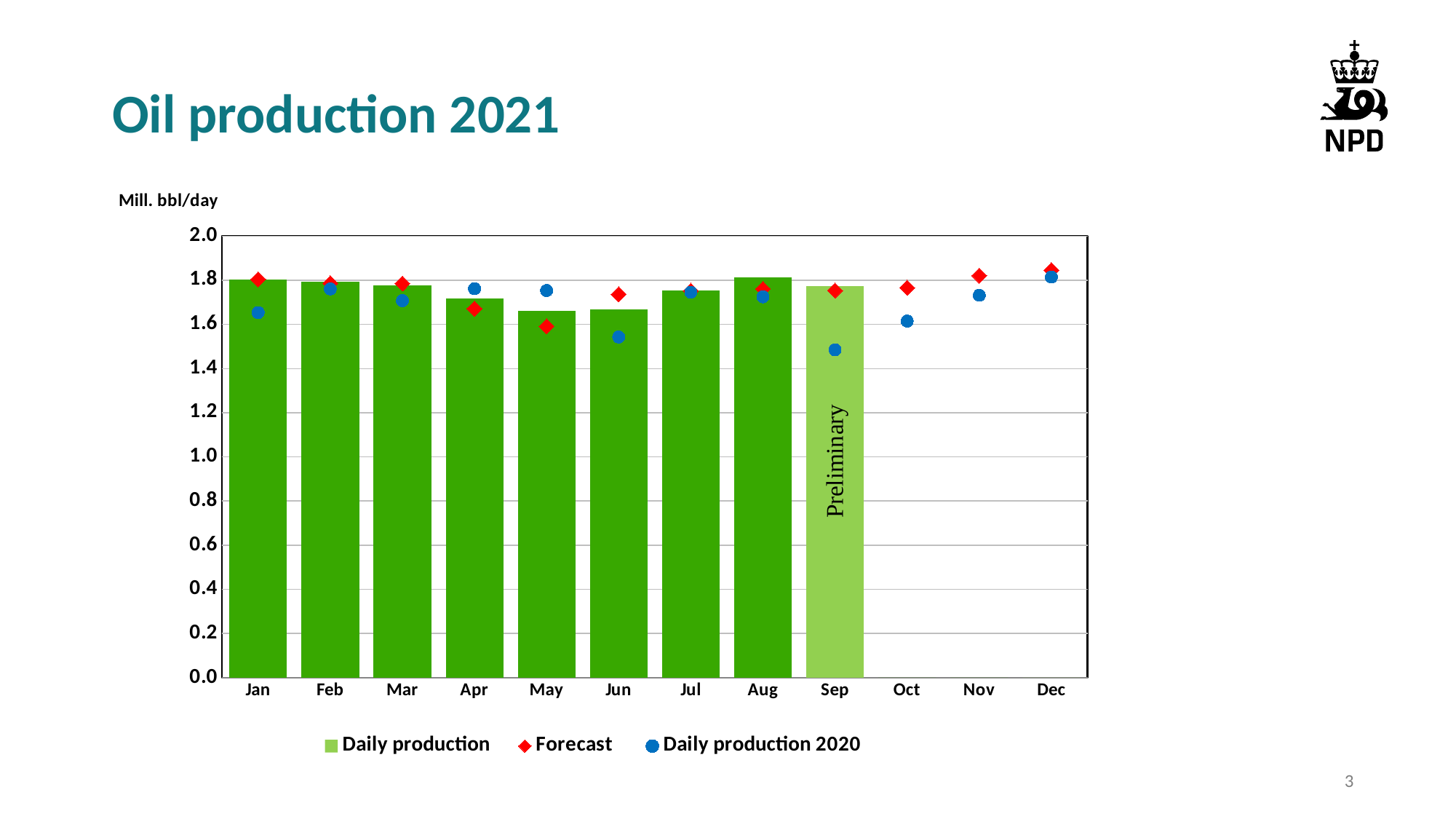
How many series does the legend list? 3 Which month has the highest Daily production bar? Aug In Jan, which is higher, the Forecast marker or the Daily production 2020 marker? Forecast Is the Daily production 2020 value for Sep greater or less than 1.6? less Do the Daily production bars rise or fall from Jan to May? fall How many months have a Daily production bar plotted? 9 Which is larger, the Daily production bar for Aug or for May? Aug How many months are shown on the x axis? 12 What kind of chart is shown on the slide? Bar chart with point markers Is the Forecast value for Dec greater or less than 1.8? greater What label is written on the Sep bar? Preliminary Is the Daily production value for Jan greater or less than 1.6? greater